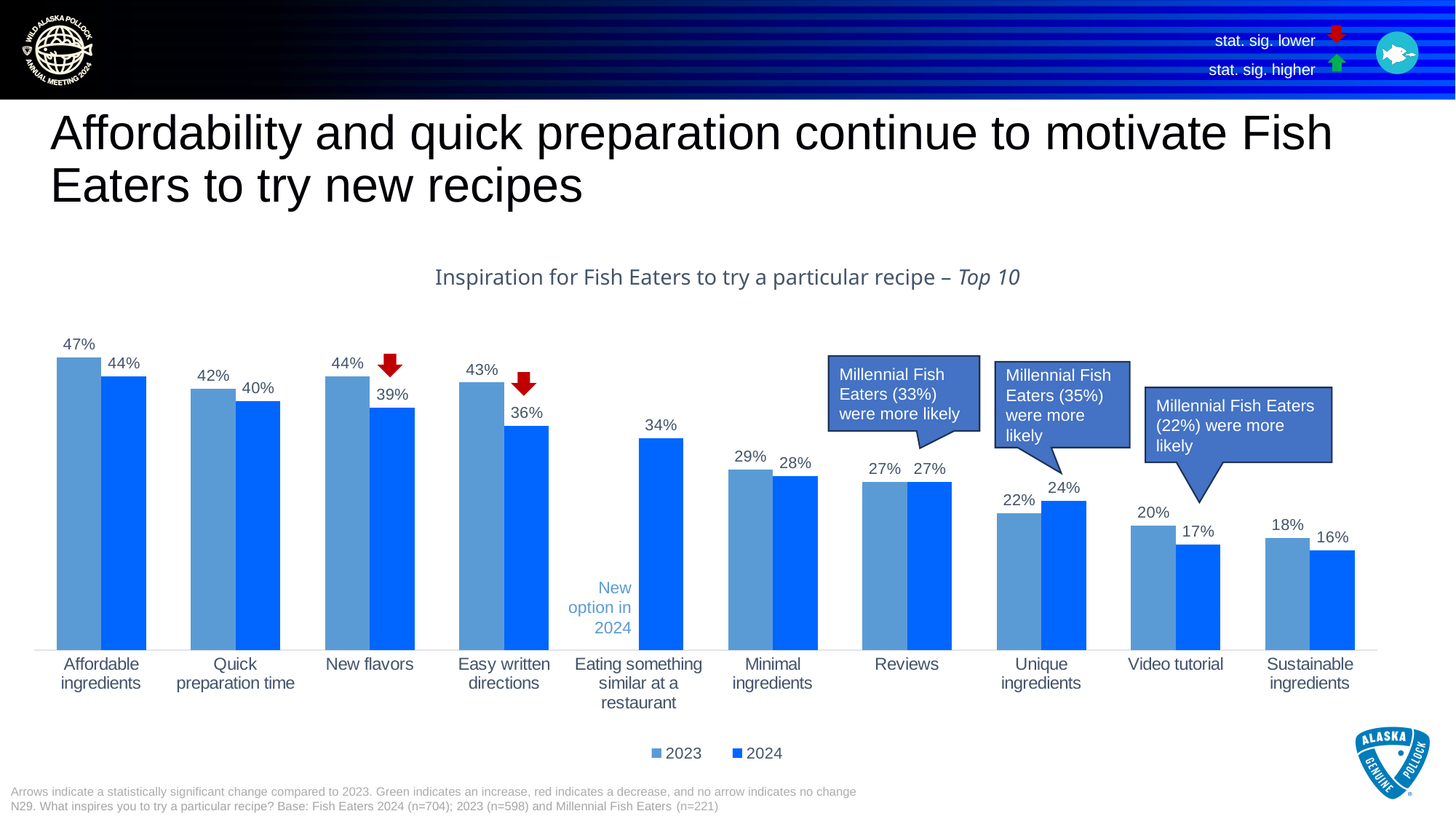
Which category has the highest 2023 value? Affordable ingredients Which category is marked as a new option in 2024? Eating something similar at a restaurant How many categories are shown on the x axis? 10 What is the title of the chart? Inspiration for Fish Eaters to try a particular recipe – Top 10 Which category has the lowest 2024 value? Sustainable ingredients How many series does the legend list? 2 What is the 2024 value for Affordable ingredients? 44% Which is larger for Unique ingredients, the 2023 value or the 2024 value? 2024 What kind of chart is shown? Bar chart What is the difference between the 2023 and 2024 values for New flavors? 5% What is the 2024 value for Eating something similar at a restaurant? 34% What is the 2023 value for Quick preparation time? 42%